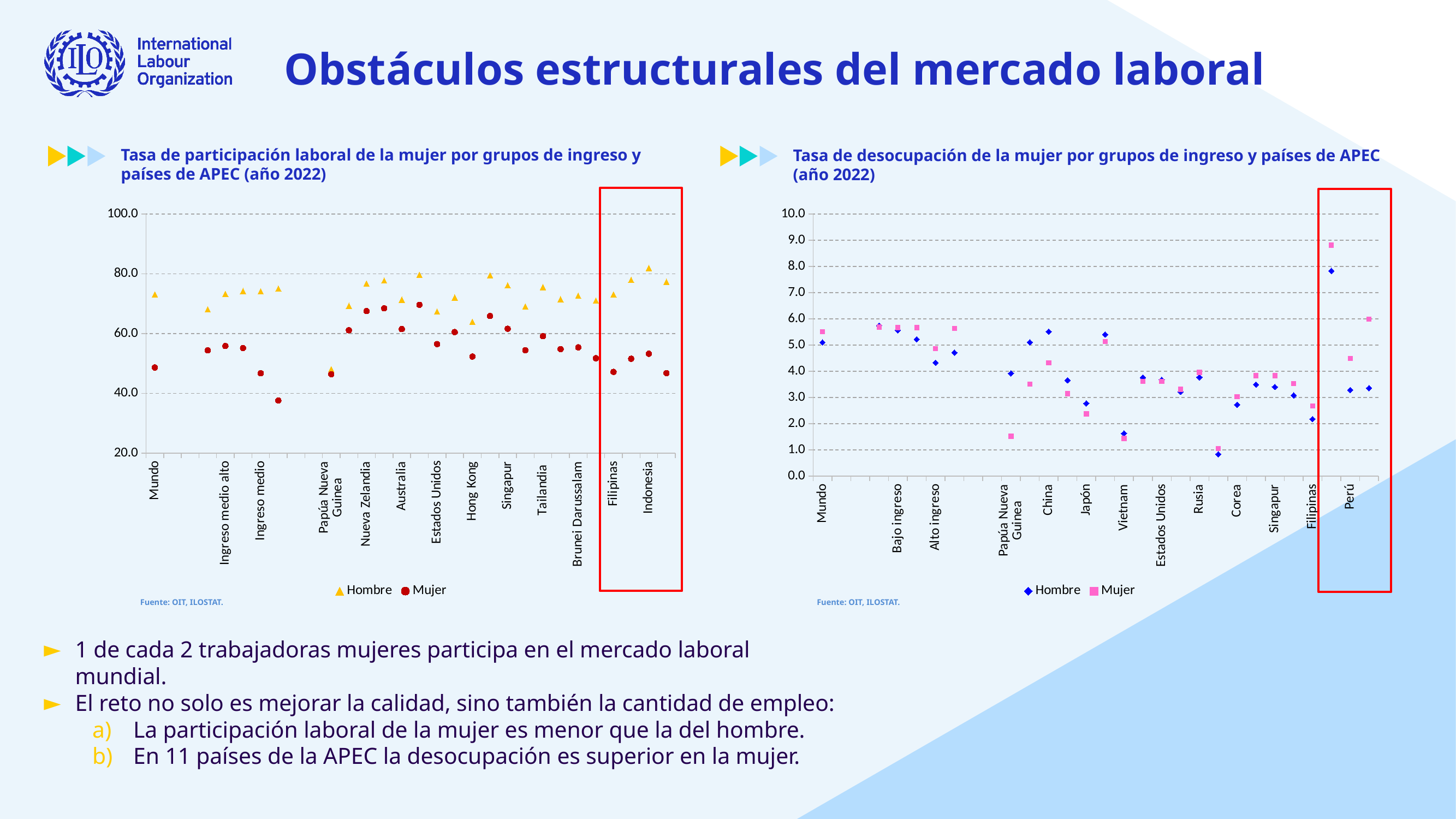
In the left chart (participación laboral), which series is shown with yellow triangles? Hombre In the left chart (participación laboral), for Mundo, which series has the larger value, Hombre or Mujer? Hombre What kind of chart is the left chart, 'Tasa de participación laboral de la mujer por grupos de ingreso y países de APEC (año 2022)'? Scatter chart In the right chart (desocupación), for Perú, which series has the larger value, Hombre or Mujer? Mujer How many series does the legend of the right chart, 'Tasa de desocupación de la mujer por grupos de ingreso y países de APEC (año 2022)', list? 2 In the right chart (desocupación), is the Mujer value for Perú greater or less than 8.0? less In the left chart (participación laboral), is the Mujer value for Nueva Zelandia greater or less than 60.0? greater In the right chart (desocupación), is the Hombre value for Corea greater or less than 2.0? greater In the right chart (desocupación), which series is shown with pink squares? Mujer